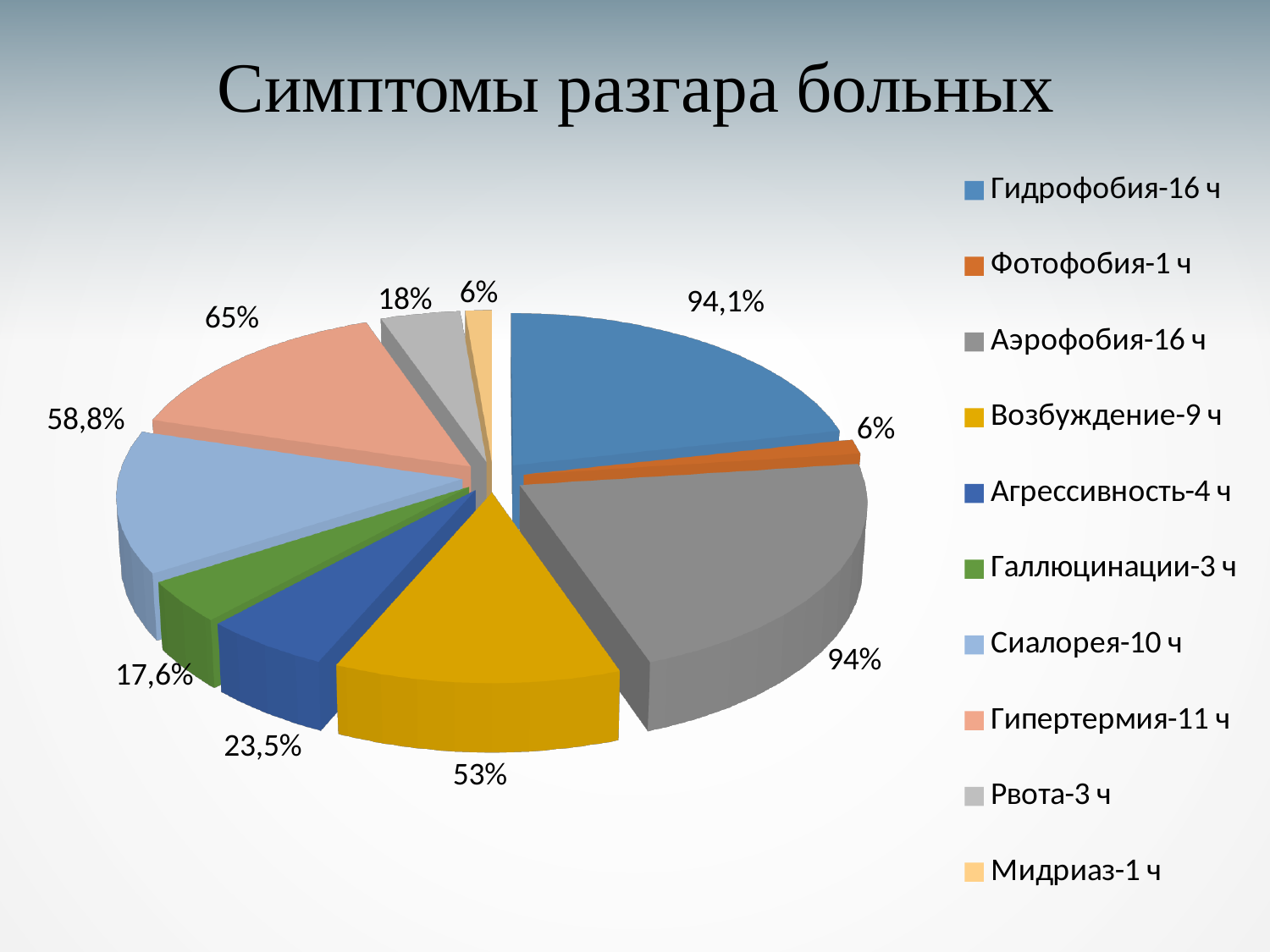
What is the value shown for Сиалорея-10 ч? 58,8% What kind of chart is shown on the slide? Pie chart What is the difference between the values for Возбуждение-9 ч and Агрессивность-4 ч? 29,5% What is the title of the chart? Симптомы разгара больных What is the value shown for Возбуждение-9 ч? 53% What is the value shown for Рвота-3 ч? 18% What is the value shown for Агрессивность-4 ч? 23,5% What is the difference between the values for Гипертермия-11 ч and Сиалорея-10 ч? 6,2% Which is larger, the value for Гипертермия-11 ч or the value for Сиалорея-10 ч? Гипертермия-11 ч What is the value shown for Гидрофобия-16 ч? 94,1% What is the value shown for Галлюцинации-3 ч? 17,6% How many categories does the pie chart show? 10